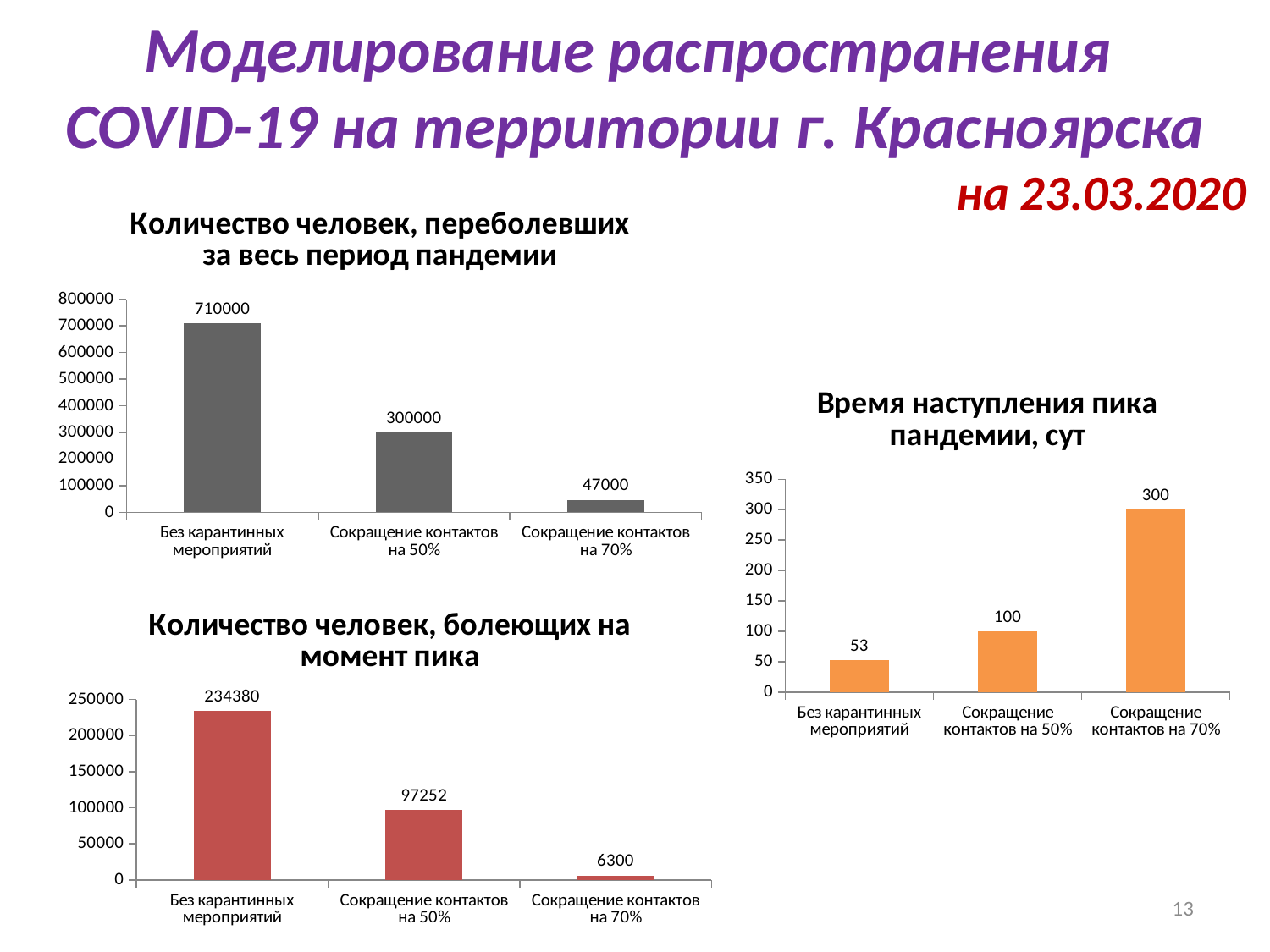
In the chart 'Количество человек, переболевших за весь период пандемии', do the values rise or fall from left to right along the x axis? fall In the chart 'Количество человек, болеющих на момент пика', what is the value for 'Сокращение контактов на 50%'? 97252 In the chart 'Количество человек, переболевших за весь период пандемии', what is the value for 'Без карантинных мероприятий'? 710000 In the chart 'Количество человек, переболевших за весь период пандемии', what is the value for 'Сокращение контактов на 70%'? 47000 In the chart 'Время наступления пика пандемии, сут', which category has the highest value? Сокращение контактов на 70% In the chart 'Время наступления пика пандемии, сут', do the values rise or fall from left to right along the x axis? rise In the chart 'Количество человек, болеющих на момент пика', which category has the lowest value? Сокращение контактов на 70% What kind of chart is 'Количество человек, болеющих на момент пика'? bar chart How many categories are shown in the chart 'Время наступления пика пандемии, сут'? 3 In the chart 'Количество человек, переболевших за весь период пандемии', what is the difference between 'Без карантинных мероприятий' and 'Сокращение контактов на 50%'? 410000 In the chart 'Время наступления пика пандемии, сут', what is the value for 'Без карантинных мероприятий'? 53 In the chart 'Количество человек, болеющих на момент пика', what is the difference between 'Без карантинных мероприятий' and 'Сокращение контактов на 50%'? 137128